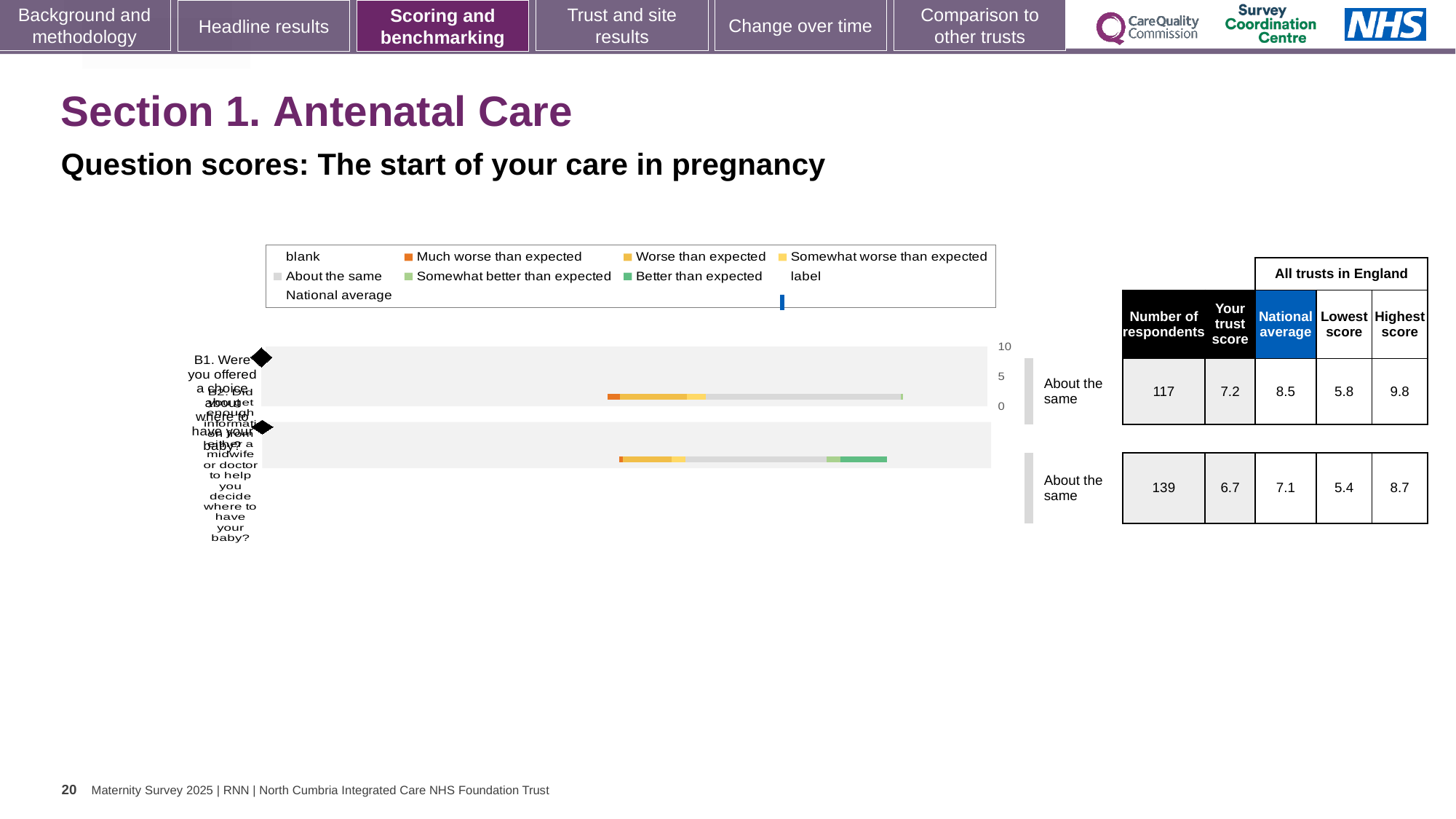
How many respondents are listed for the second row (B2)? 139 What kind of chart is shown on the slide? bar chart What is the difference between the national average and the trust score for the first row (B1)? 1.3 In the chart legend, what colour represents 'Better than expected'? green What is the 'Your trust score' for the second row (B2)? 6.7 How many question rows (bars) does the chart show? 2 What is the highest score across all trusts in England for the first row (B1)? 9.8 What is the national average for the first row (B1)? 8.5 What benchmark category is shown next to both rows of the chart? About the same In the chart legend, what colour represents 'Much worse than expected'? orange What is the 'Your trust score' for the first row (B1, choice about where to have your baby)? 7.2 Which row has the higher 'Your trust score', B1 or B2? B1